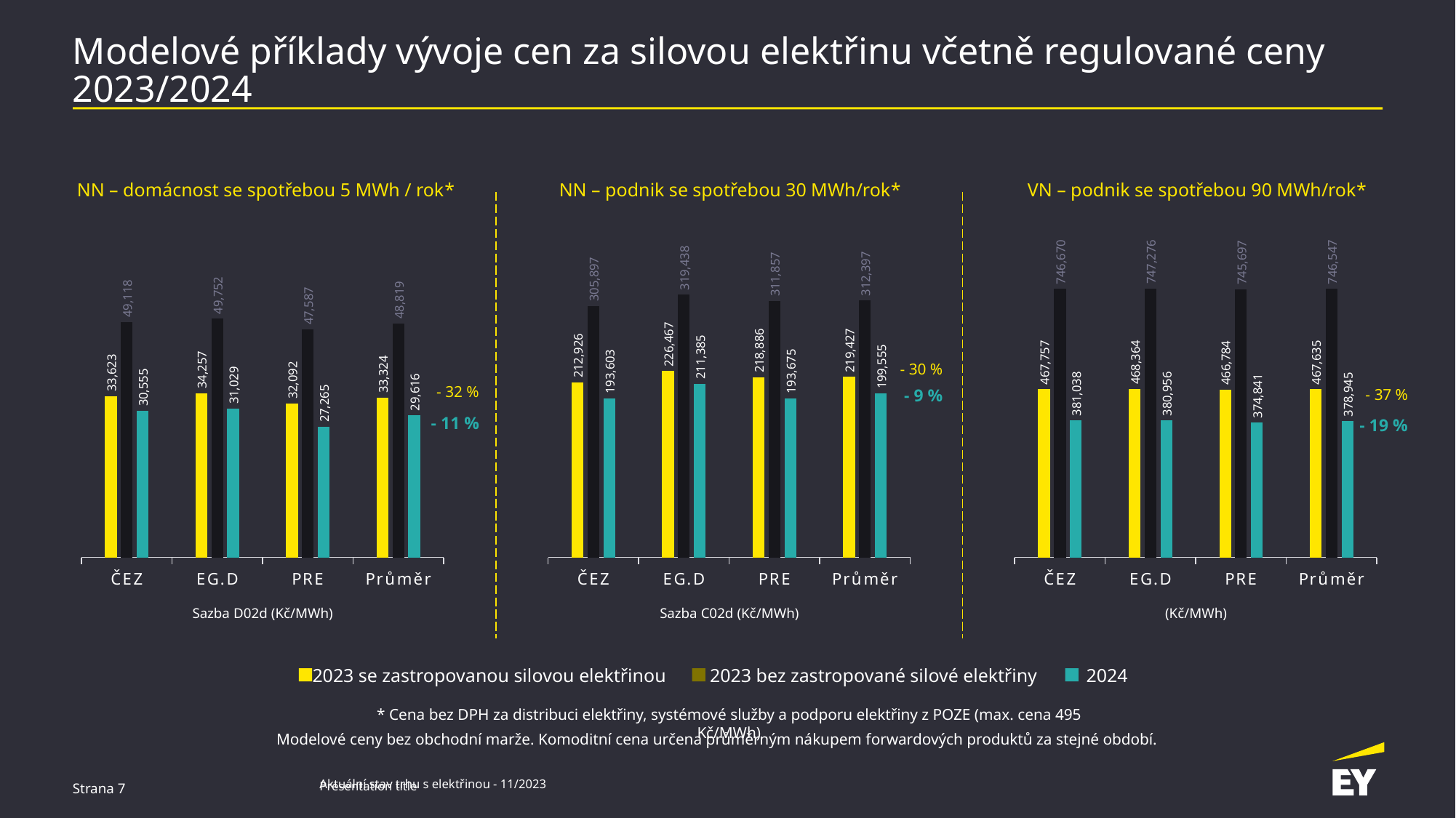
How many categories are shown on the x axis of the chart titled 'VN – podnik se spotřebou 90 MWh/rok*'? 4 In the chart titled 'VN – podnik se spotřebou 90 MWh/rok*', what is the value for ČEZ in the '2023 se zastropovanou silovou elektřinou' series? 467,757 In the chart titled 'NN – podnik se spotřebou 30 MWh/rok*', what is the difference between the '2023 se zastropovanou silovou elektřinou' value and the 2024 value for Průměr? 19,872 In the chart titled 'NN – domácnost se spotřebou 5 MWh / rok*', what is the difference between the '2023 bez zastropované silové elektřiny' value and the 2024 value for ČEZ? 18,563 In the chart titled 'NN – domácnost se spotřebou 5 MWh / rok*', what is the 2024 value for PRE? 27,265 In the chart titled 'NN – podnik se spotřebou 30 MWh/rok*', what is the value for EG.D in the '2023 bez zastropované silové elektřiny' series? 319,438 What kind of chart is the chart titled 'NN – podnik se spotřebou 30 MWh/rok*'? Bar chart How many series does the shared legend at the bottom of the slide list? 3 In the chart titled 'NN – domácnost se spotřebou 5 MWh / rok*', which category has the highest 2024 value? EG.D In the chart titled 'NN – domácnost se spotřebou 5 MWh / rok*', which is larger: the 2024 value for ČEZ or the 2024 value for PRE? ČEZ In the chart titled 'NN – podnik se spotřebou 30 MWh/rok*', which category has the lowest 2024 value? ČEZ In the chart titled 'VN – podnik se spotřebou 90 MWh/rok*', which category has the lowest 2024 value? PRE